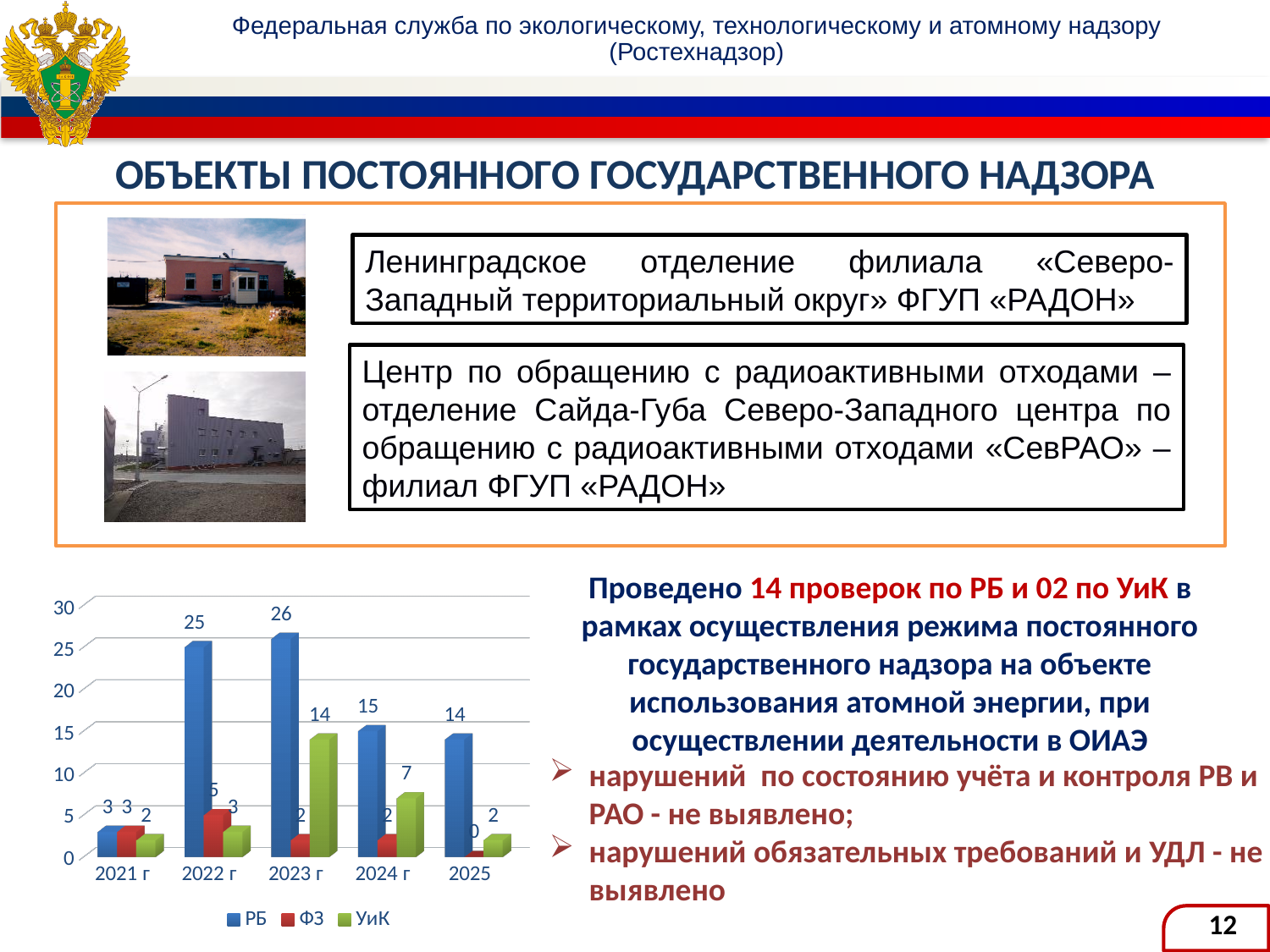
Is the value for РБ in 2022 г greater or less than 20? greater How many years are shown on the x axis of the chart? 5 In which year is the РБ value lowest? 2021 г How many series does the chart legend list? 3 What is the value for РБ in 2023 г? 26 What is the difference between the РБ values for 2023 г and 2024 г? 11 Which is larger: the УиК value in 2023 г or the УиК value in 2024 г? 2023 г In which year is the РБ value highest? 2023 г What kind of chart is shown on the slide? bar chart What is the value for РБ in 2022 г? 25 What is the value for УиК in 2024 г? 7 What is the value for РБ in 2025? 14